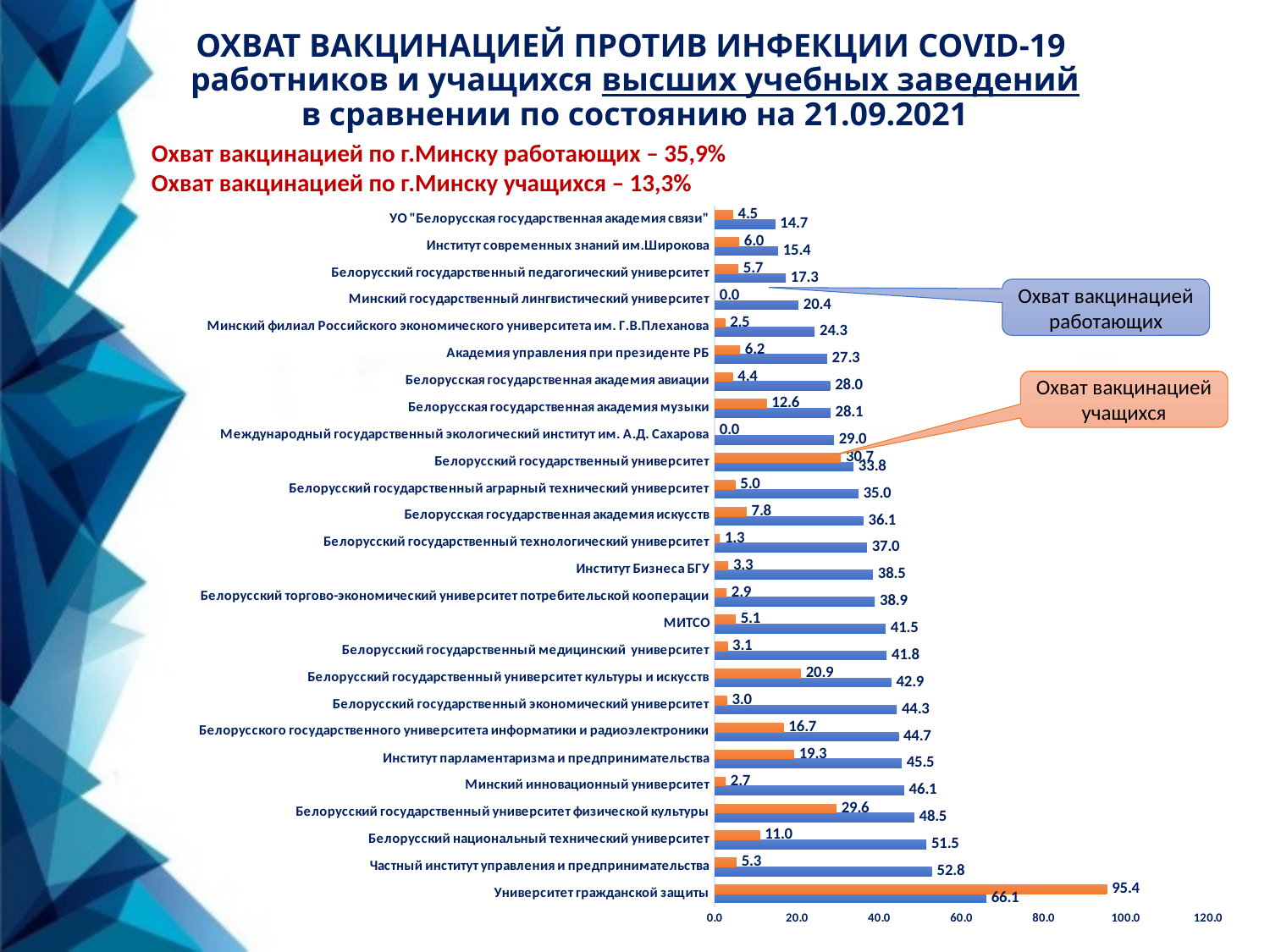
What is the value of 'Охват вакцинацией учащихся' for Белорусский государственный университет культуры и искусств? 20.9 How many institutions (categories) are listed on the chart? 26 What is the value of 'Охват вакцинацией учащихся' for Минский государственный лингвистический университет? 0.0 Which institution has the highest value for 'Охват вакцинацией работающих'? Университет гражданской защиты Which institution has the lowest value for 'Охват вакцинацией работающих'? УО "Белорусская государственная академия связи" What is the value of 'Охват вакцинацией работающих' for Белорусский национальный технический университет? 51.5 How many series does the chart show (as labelled by the callouts)? 2 What kind of chart is shown on the slide? bar chart Which colour represents 'Охват вакцинацией учащихся' on the chart? orange What is the difference between 'Охват вакцинацией учащихся' and 'Охват вакцинацией работающих' for Университет гражданской защиты? 29.3 Is the value of 'Охват вакцинацией работающих' for Частный институт управления и предпринимательства greater or less than 40.0? greater Which is larger for Белорусский государственный университет: 'Охват вакцинацией работающих' or 'Охват вакцинацией учащихся'? Охват вакцинацией работающих